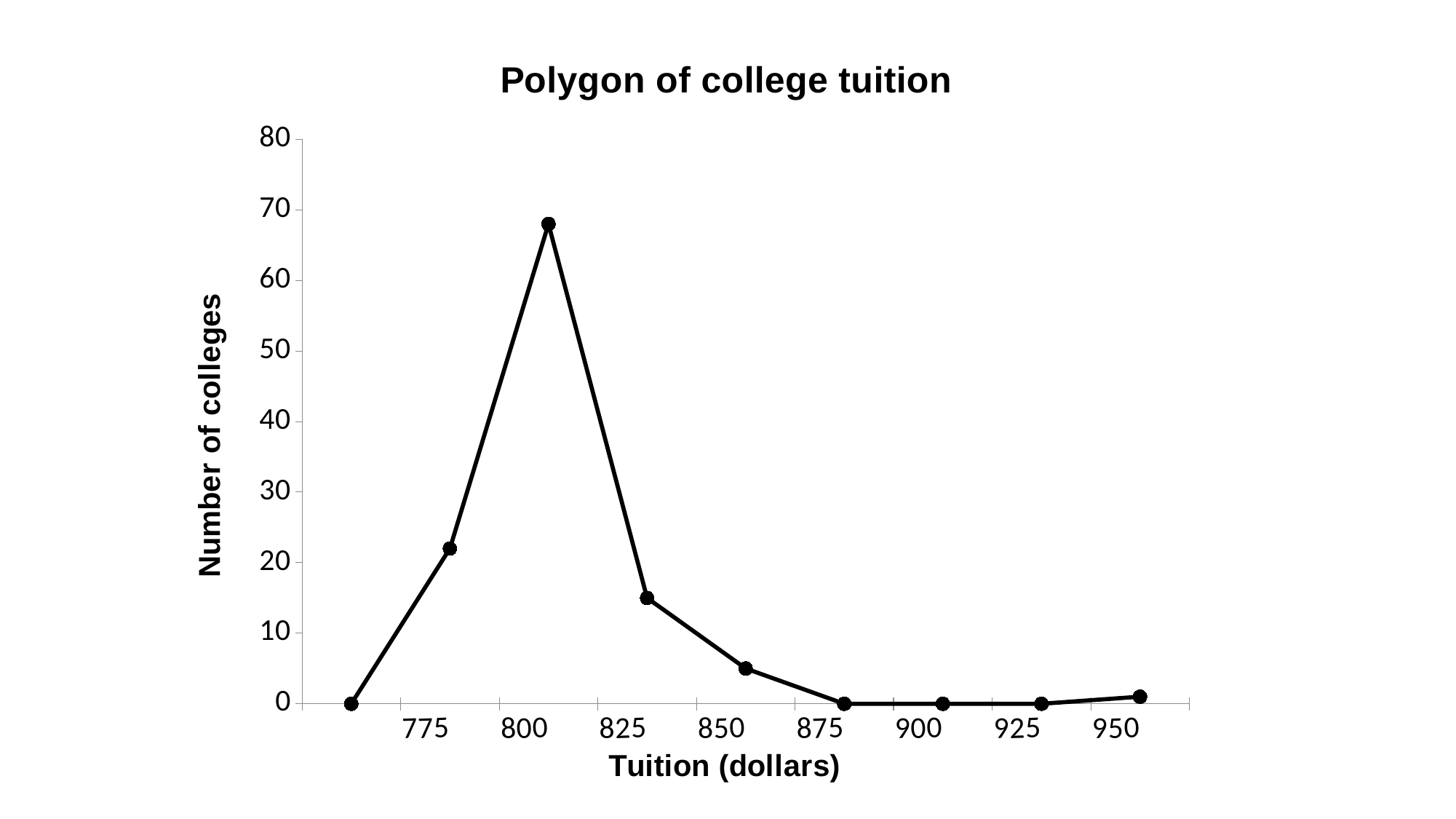
Does the line rise or fall between the peak and the point between 850 and 875? fall Between which two x-axis tick labels does the highest point of the line fall? 800 and 825 What is the title of the chart? Polygon of college tuition Is the value of the point between 825 and 850 on the x axis greater or less than 20? less How many data points are plotted on the line? 9 Is the value of the point between 850 and 875 on the x axis greater or less than 10? less Is the value of the point between 775 and 800 on the x axis greater or less than 20? greater What is the value of the first (leftmost) point on the line? 0 What is the label of the vertical axis? Number of colleges What kind of chart is shown on the slide? line chart Which is larger: the value of the point between 775 and 800, or the value of the point between 825 and 850? the point between 775 and 800